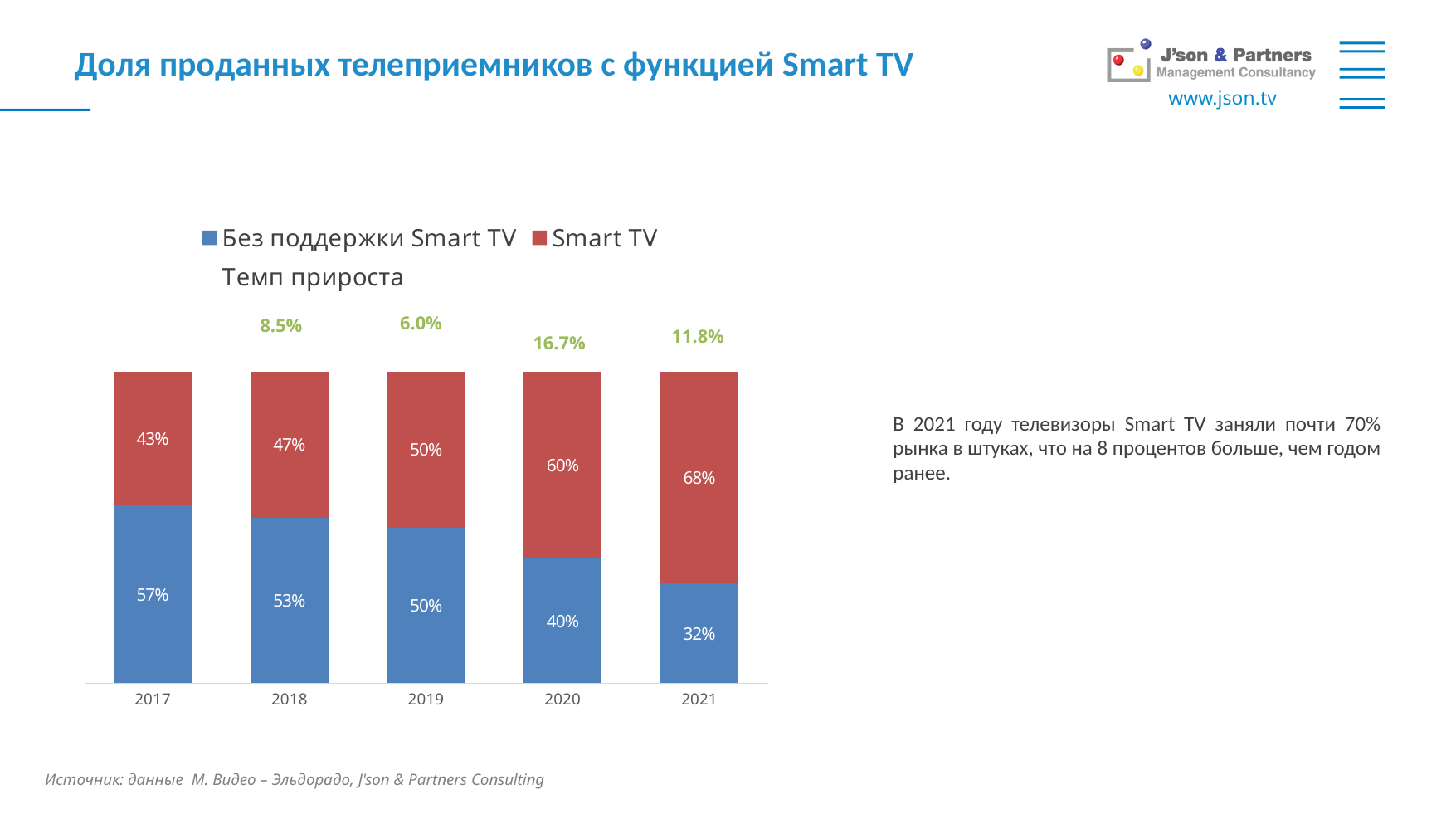
How many years are shown on the x axis? 5 In which year is the 'Без поддержки Smart TV' share the lowest? 2021 Does the Smart TV share rise or fall from 2017 to 2021? Rise What is the total of the stacked bar for 2019? 100% What is the difference between the Smart TV share in 2021 and in 2020? 8% What is the Smart TV share for 2021? 68% Which is larger in 2018: the Smart TV share or the 'Без поддержки Smart TV' share? Без поддержки Smart TV In which year is the Smart TV share the highest? 2021 What is the 'Темп прироста' value shown above the 2020 bar? 16.7% How many series does the legend list? 3 What is the value for 'Без поддержки Smart TV' in 2017? 57% What kind of chart is shown on the slide? Stacked bar chart